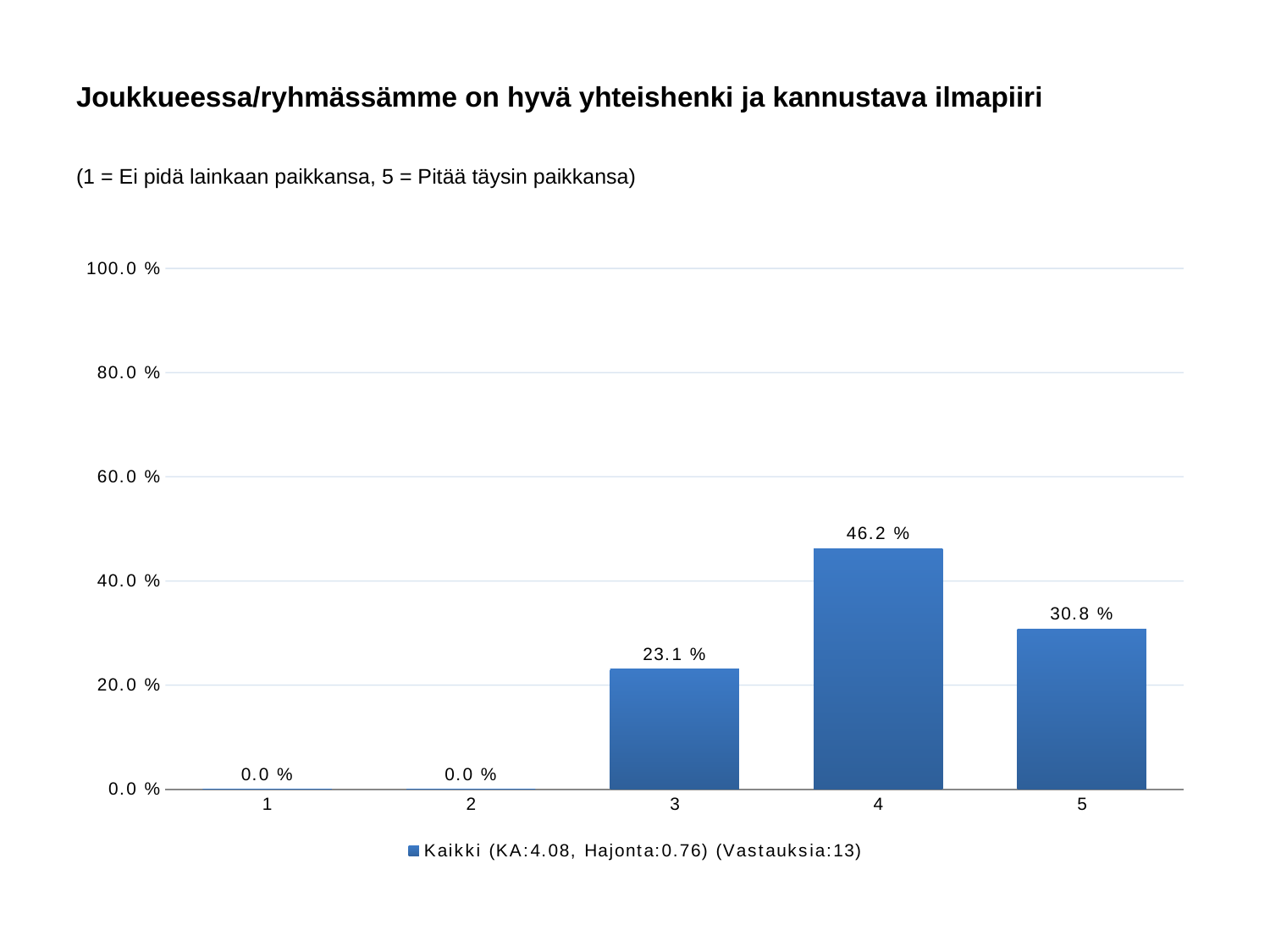
How many categories are shown on the x axis? 5 Which category has the highest value? 4 What is the value for category 5? 30.8 % What kind of chart is shown on the slide? bar chart What is the value for category 3? 23.1 % Is the value for category 4 greater or less than 40.0 %? greater What is the value for category 1? 0.0 % What is the difference between the values for categories 4 and 5? 15.4 % How many series does the legend list? 1 What is the legend entry for the series? Kaikki (KA:4.08, Hajonta:0.76) (Vastauksia:13) What is the value for category 4? 46.2 % Which is larger, the value for category 3 or the value for category 5? 5